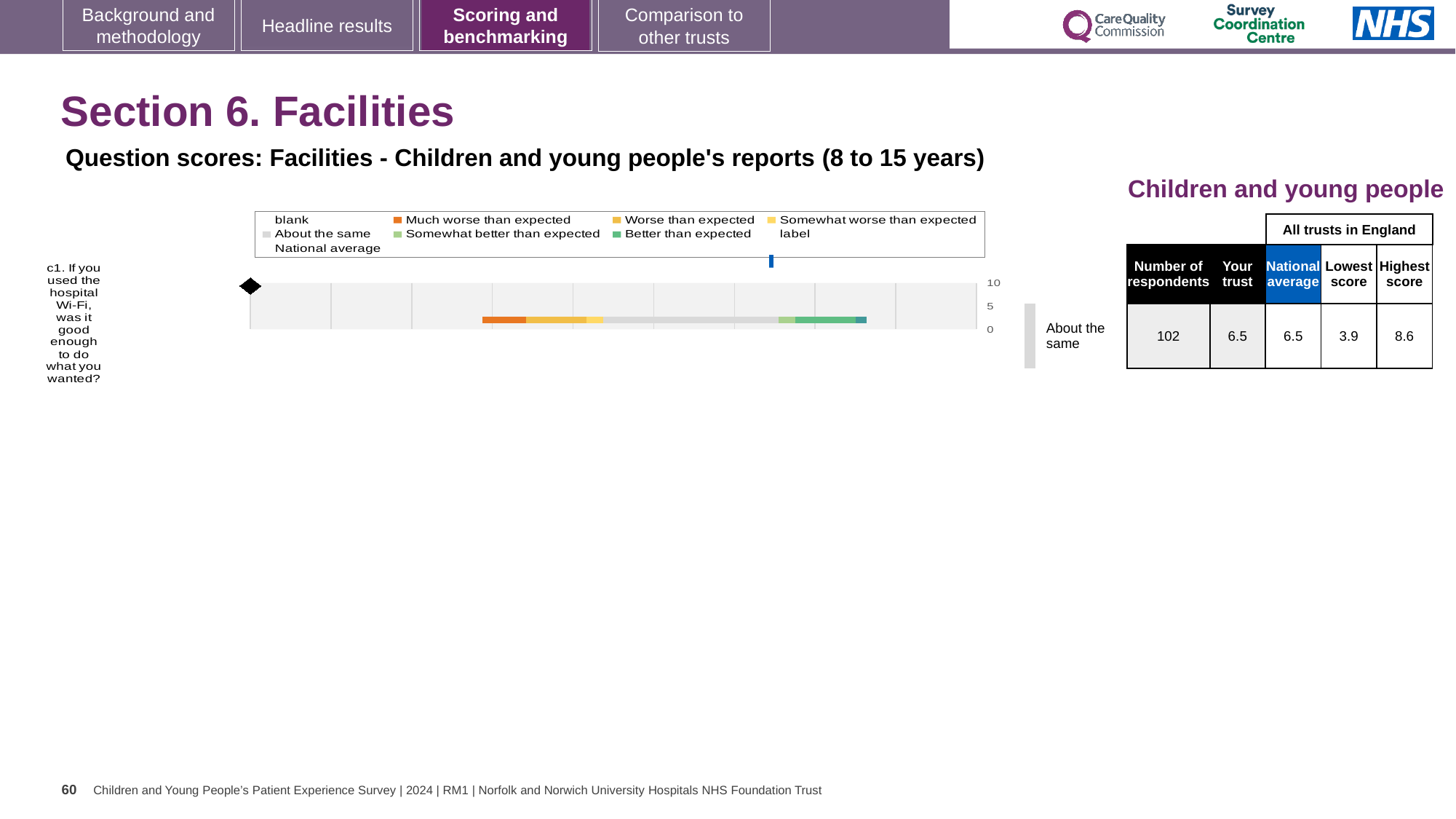
What kind of chart is used to show the question score for c1 on this slide? bar chart Which survey question is plotted in the chart? c1. If you used the hospital Wi-Fi, was it good enough to do what you wanted? What is the national average score for question c1? 6.5 Is the trust's score for question c1 greater or less than 5? greater What is the highest score among all trusts in England for question c1? 8.6 How many entries does the chart's legend list? 9 How many respondents answered question c1? 102 How many survey questions are plotted in the chart on this slide? 1 What is the difference between the highest and lowest scores for question c1? 4.7 Which benchmark category is the trust's score for question c1 placed in? About the same What is the trust's score for question c1 about the hospital Wi-Fi? 6.5 What is the lowest score among all trusts in England for question c1? 3.9